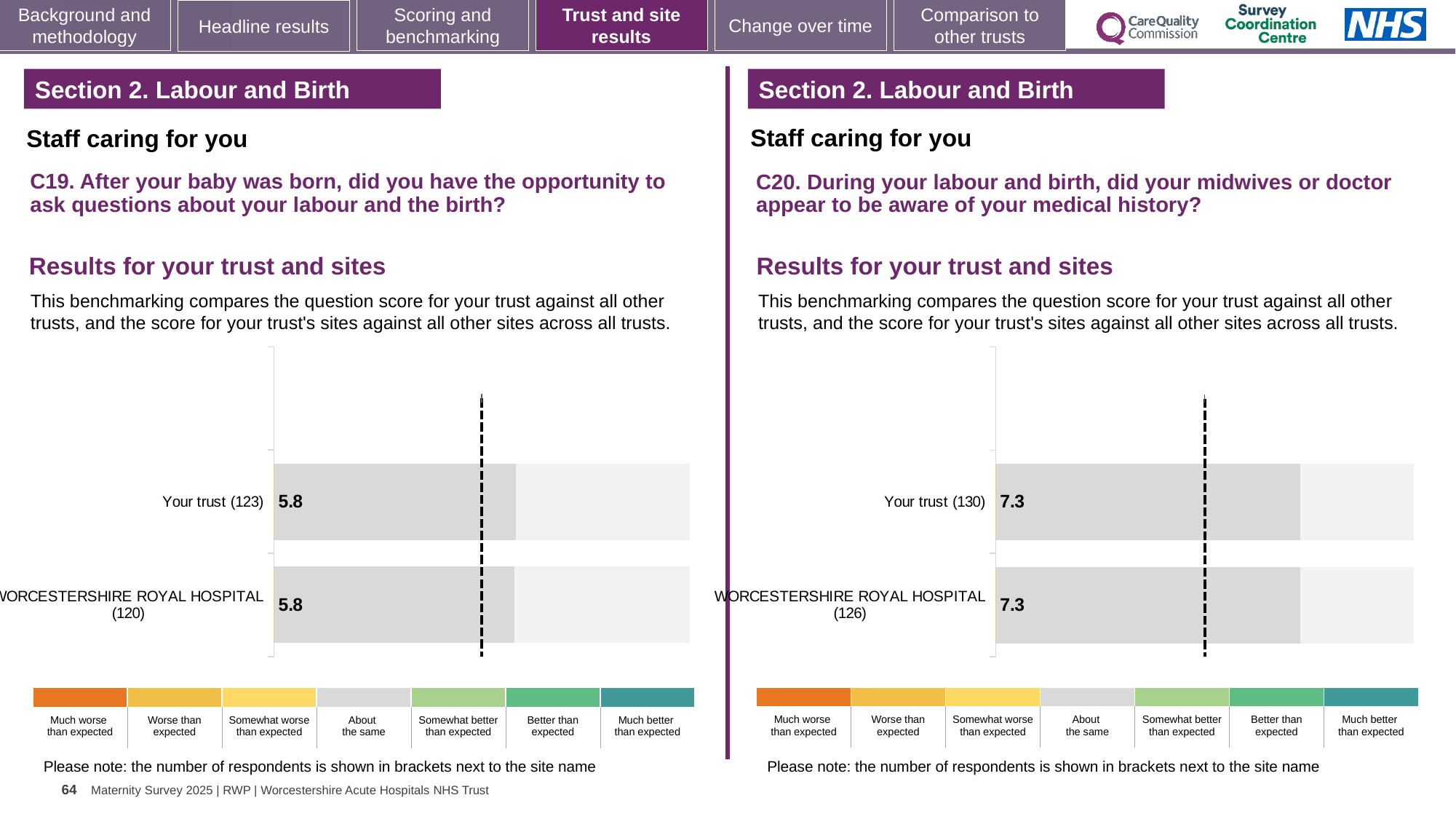
In the C20 chart on the right, what is the score for Your trust (130)? 7.3 How many rating categories does the colour key below the C19 chart on the left show? 7 In the C20 chart on the right, what is the score for Worcestershire Royal Hospital (126)? 7.3 In the C19 chart on the left, what is the score for Your trust (123)? 5.8 In the colour key below the C20 chart on the right, which category is shown in orange at the far left? Much worse than expected In the C19 chart on the left, what is the difference between the score for Your trust and the score for Worcestershire Royal Hospital? 0 Is the score for Your trust higher in the C19 chart on the left or in the C20 chart on the right? C20 chart on the right How many bars are plotted in the C20 chart on the right? 2 In the C19 chart on the left, what is the score for Worcestershire Royal Hospital (120)? 5.8 What kind of chart is used in the C19 chart on the left? Bar chart In the C19 chart on the left, how many respondents are shown in brackets for Your trust? 123 In the C20 chart on the right, how many respondents are shown in brackets for Worcestershire Royal Hospital? 126